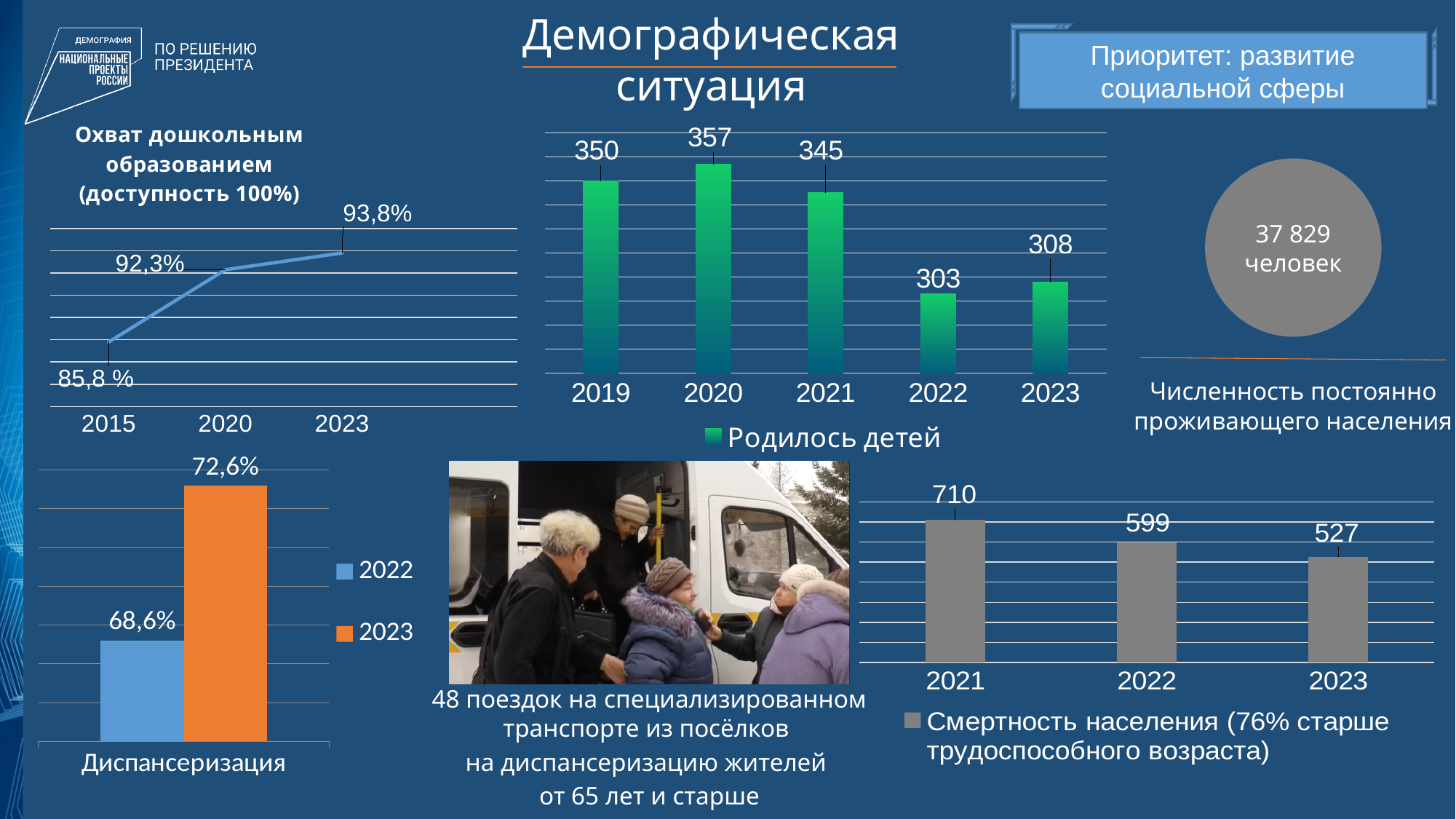
In the 'Родилось детей' chart, which year has the lowest value? 2022 What type of chart is the 'Родилось детей' chart? bar chart In the 'Смертность населения' chart, which is larger: the value for 2021 or the value for 2023? 2021 In the 'Охват дошкольным образованием' line chart, what is the value for 2020? 92,3% In the 'Смертность населения' chart, what is the difference between the values for 2022 and 2023? 72 In the 'Охват дошкольным образованием' line chart, do the values rise or fall from 2015 to 2023? rise In the 'Диспансеризация' chart, what is the value for 2023? 72,6% In the 'Родилось детей' chart, what is the difference between the values for 2019 and 2023? 42 In the 'Смертность населения' chart, what is the value for 2021? 710 In the 'Родилось детей' chart, what is the value for 2020? 357 How many series does the legend of the 'Диспансеризация' chart list? 2 How many years are shown on the x axis of the 'Родилось детей' chart? 5